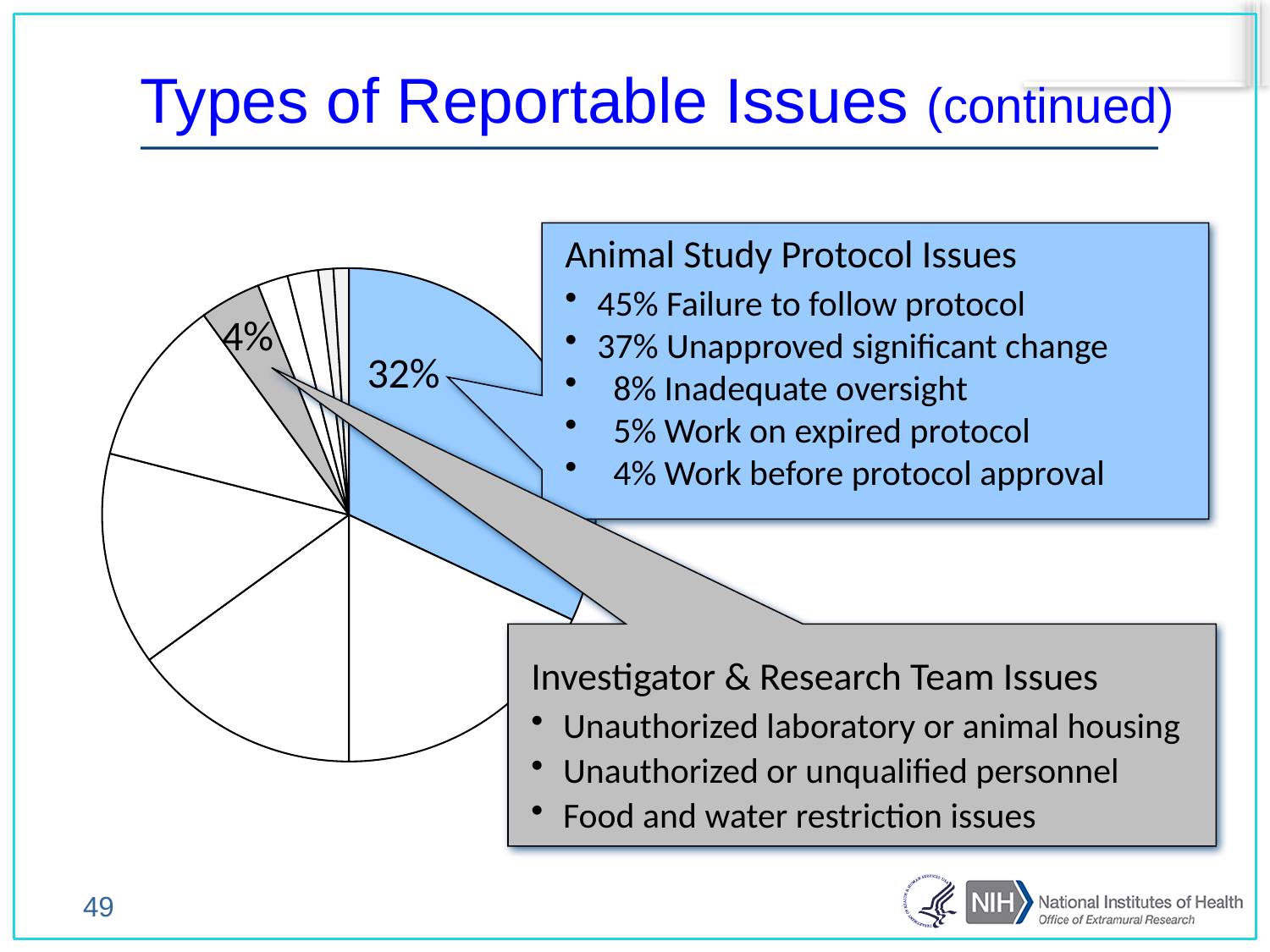
What kind of chart is shown on the slide? pie chart What share of the pie does the Animal Study Protocol Issues slice represent? 32% What share of the pie does the Investigator & Research Team Issues slice represent? 4% Which slice is larger: Animal Study Protocol Issues or Investigator & Research Team Issues? Animal Study Protocol Issues What is the difference in percentage points between the Animal Study Protocol Issues slice and the Investigator & Research Team Issues slice? 28 What colour is the slice labelled 32%? blue What colour is the slice labelled 4%? gray